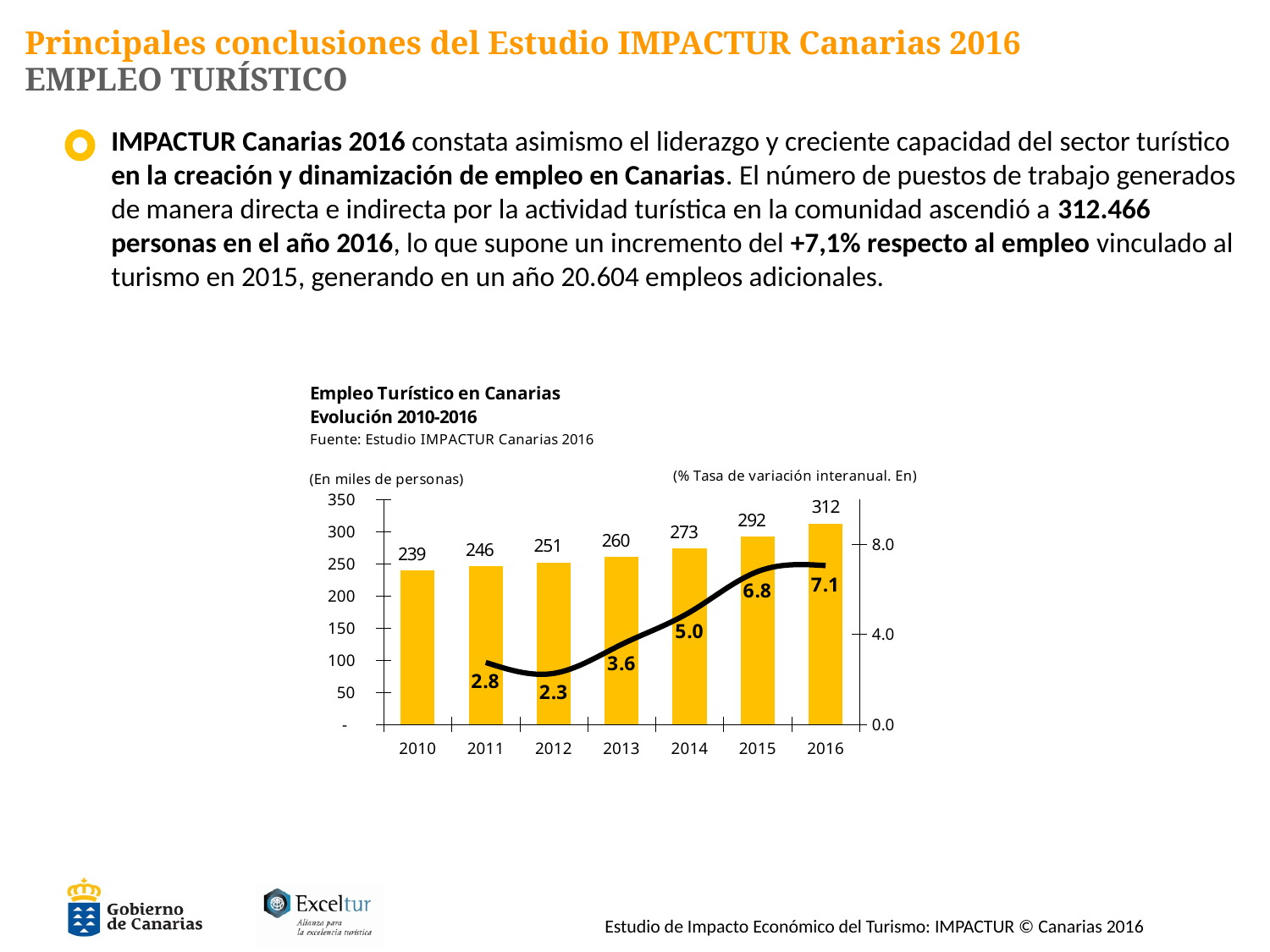
What is the year-on-year variation rate (%) shown for 2014? 5.0 Which year has the lowest year-on-year variation rate on the line? 2012 What is the difference between the tourism employment values for 2016 and 2015 (in thousands of persons)? 20 What is the difference between the variation rates for 2013 and 2012? 1.3 What is the title of the chart? Empleo Turístico en Canarias Evolución 2010-2016 Do the tourism employment bars rise or fall from 2010 to 2016? Rise What is the tourism employment value (in thousands of persons) shown for 2010? 239 Which is larger, the variation rate for 2015 or for 2016? 2016 How many years are shown on the x axis of the chart? 7 What kind of chart is shown on the slide? Combined bar and line chart Which year has the highest tourism employment bar? 2016 What is the tourism employment value (in thousands of persons) shown for 2016? 312